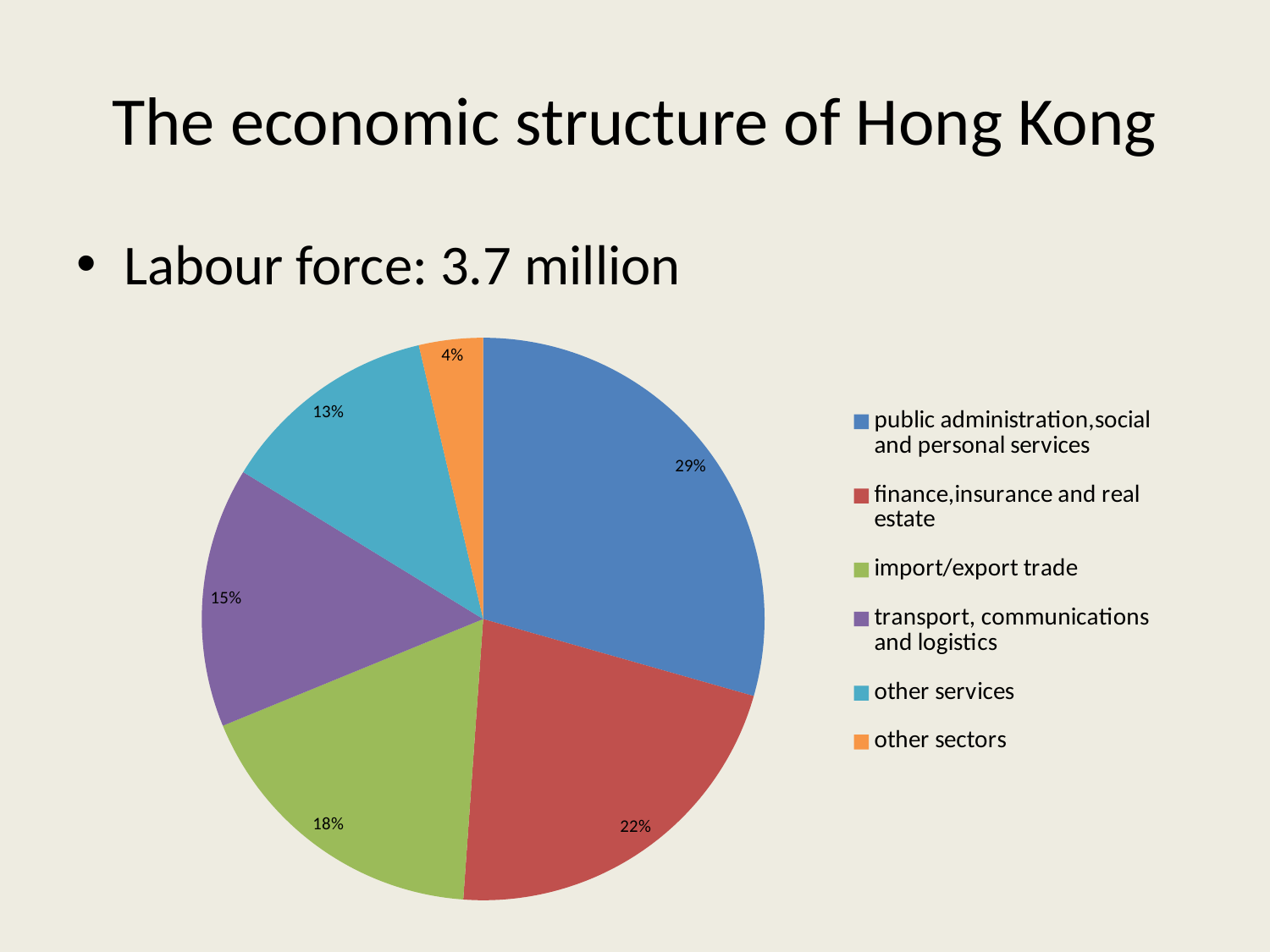
Which is larger: the slice for import/export trade or the slice for other services? import/export trade What share of the pie does transport, communications and logistics have? 15% What colour is the slice for other sectors? orange Which sector has the largest slice of the pie? public administration, social and personal services What is the difference in percentage points between public administration, social and personal services and finance, insurance and real estate? 7 What share of the pie does public administration, social and personal services have? 29% What share of the pie does finance, insurance and real estate have? 22% Which sector has the smallest slice of the pie? other sectors What share of the pie does import/export trade have? 18% What share of the pie does other services have? 13% How many slices does the pie chart have? 6 What kind of chart is shown on the slide? pie chart